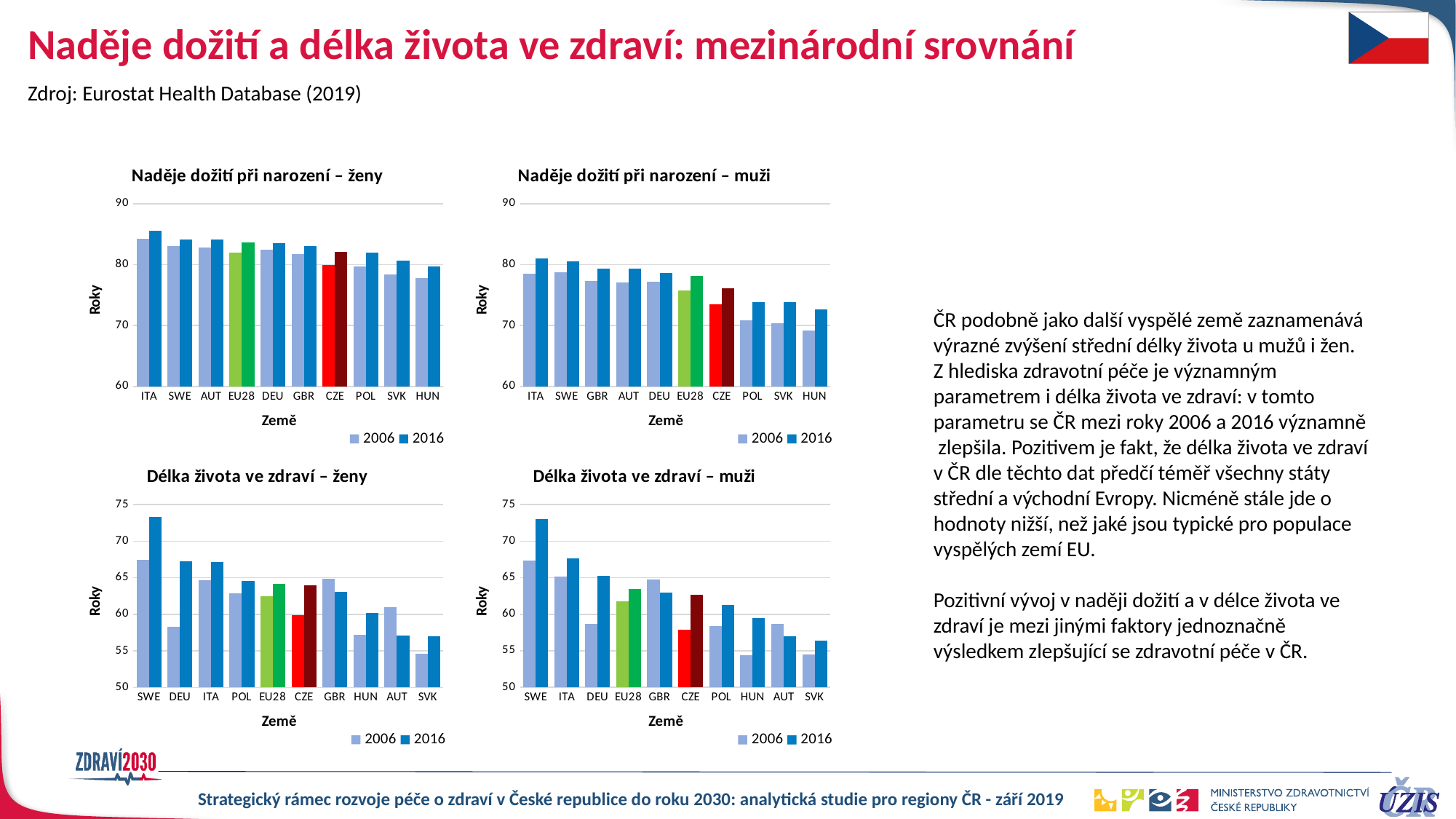
In the chart 'Délka života ve zdraví – muži', is the 2006 value for CZE greater or less than 60? less In the chart 'Naděje dožití při narození – muži', which is larger for CZE: the 2006 value or the 2016 value? 2016 In the chart 'Naděje dožití při narození – ženy', is the 2006 value for SVK greater or less than 80? less In the chart 'Délka života ve zdraví – ženy', is the 2016 value for CZE greater or less than 60? greater In the chart 'Naděje dožití při narození – ženy', how many countries/regions are shown on the x axis? 10 In the chart 'Délka života ve zdraví – ženy', which country has the highest bar? SWE What type of chart is 'Délka života ve zdraví – muži'? bar chart In the chart 'Naděje dožití při narození – muži', which country has the lowest bar? HUN In the chart 'Délka života ve zdraví – muži', how many series does the legend list? 2 In the chart 'Délka života ve zdraví – ženy', which is larger in 2016: CZE or HUN? CZE In the chart 'Naděje dožití při narození – ženy', which country has the highest bar? ITA